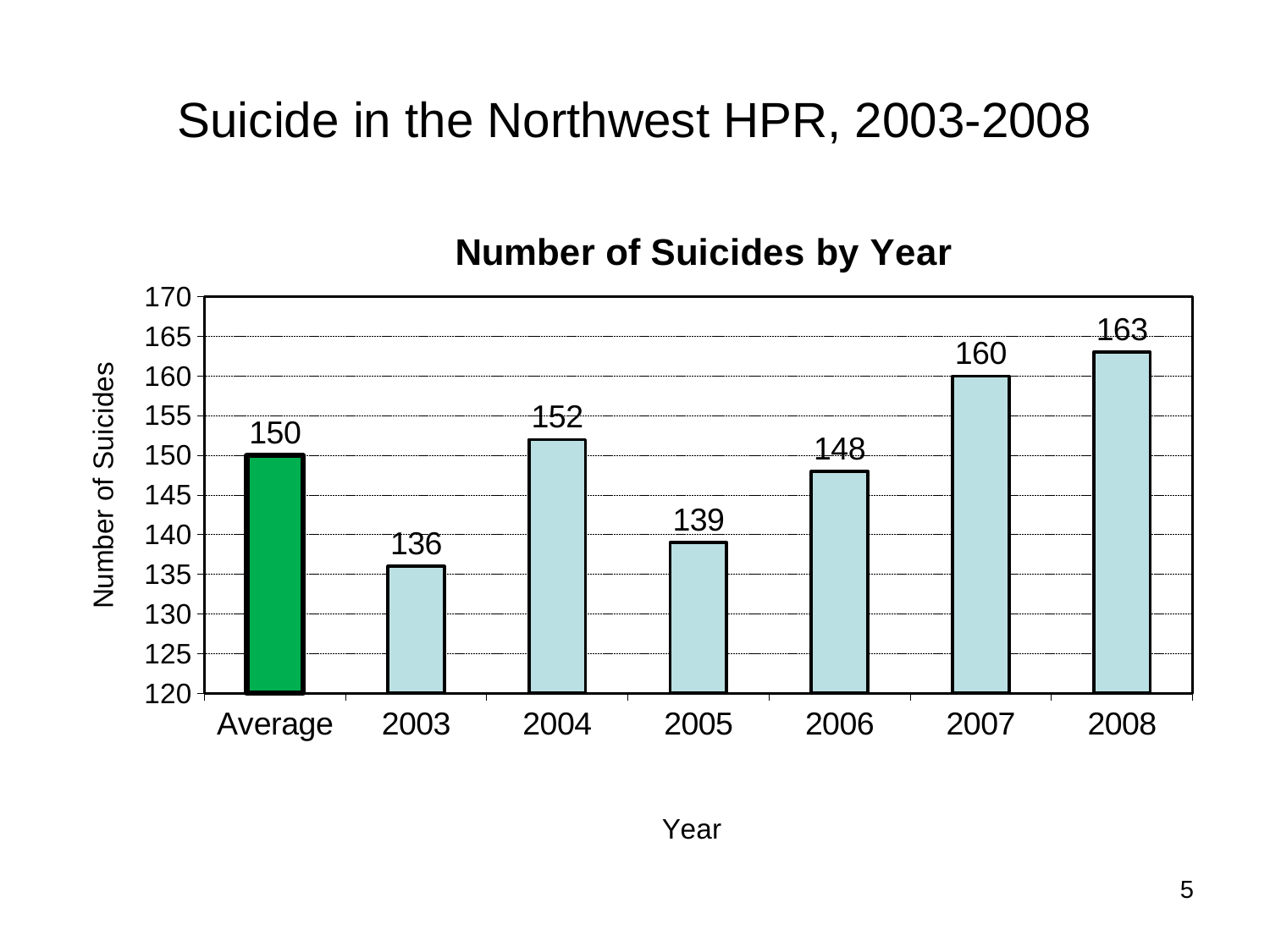
Which year has the highest number of suicides? 2008 Which year has the lowest number of suicides? 2003 What is the number of suicides shown for 2007? 160 Which is larger, the value for 2006 or the Average value? Average Is the value for 2005 greater or less than 140? less What is the difference between the number of suicides in 2008 and in 2003? 27 How many bars are shown in the chart? 7 What is the difference between the 2004 value and the 2005 value? 13 What kind of chart is shown on the slide? bar chart What value is shown for the Average bar? 150 What is the number of suicides shown for 2003? 136 What is the title of the chart? Number of Suicides by Year